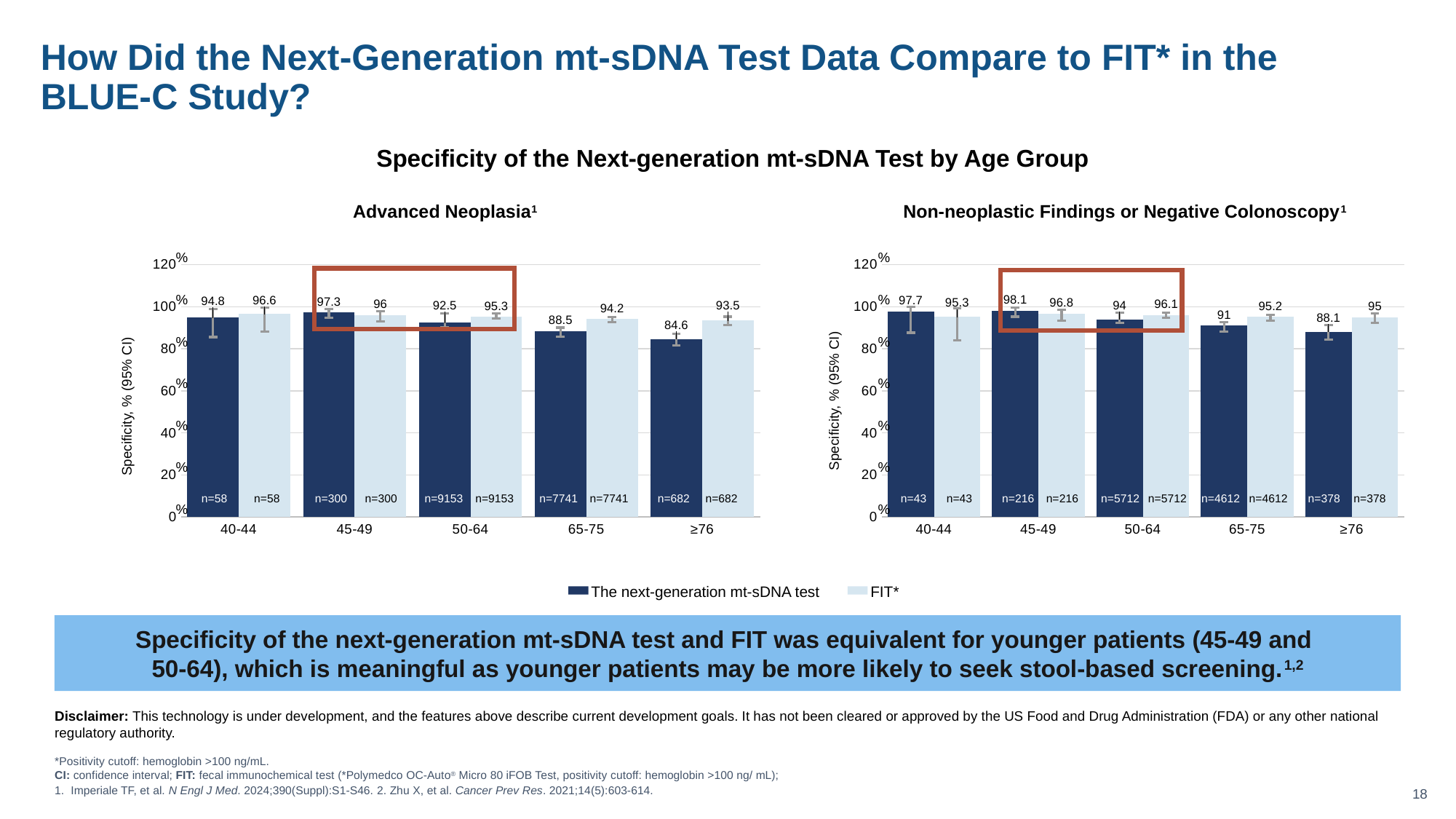
In the Non-neoplastic Findings or Negative Colonoscopy chart, which is larger for the 40-44 age group: the next-generation mt-sDNA test specificity or the FIT specificity? The next-generation mt-sDNA test What type of chart is the Non-neoplastic Findings or Negative Colonoscopy chart? Bar chart In the Advanced Neoplasia chart, what is the specificity of the next-generation mt-sDNA test for the 45-49 age group? 97.3 How many age groups are shown on the x axis of the Advanced Neoplasia chart? 5 How many series does the legend list for the charts? 2 In the Non-neoplastic Findings or Negative Colonoscopy chart, what is the specificity of the next-generation mt-sDNA test for the 50-64 age group? 94 In the Non-neoplastic Findings or Negative Colonoscopy chart, which age group has the highest specificity for the next-generation mt-sDNA test? 45-49 In the Advanced Neoplasia chart, which age group has the lowest specificity for the next-generation mt-sDNA test? ≥76 In the Non-neoplastic Findings or Negative Colonoscopy chart, what is the FIT specificity for the 65-75 age group? 95.2 In the Advanced Neoplasia chart, does the specificity of the next-generation mt-sDNA test rise or fall across the age groups from 45-49 to ≥76? Fall In the Advanced Neoplasia chart, what is the FIT specificity for the ≥76 age group? 93.5 In the Advanced Neoplasia chart, what is the difference between the FIT specificity and the next-generation mt-sDNA test specificity for the 65-75 age group? 5.7